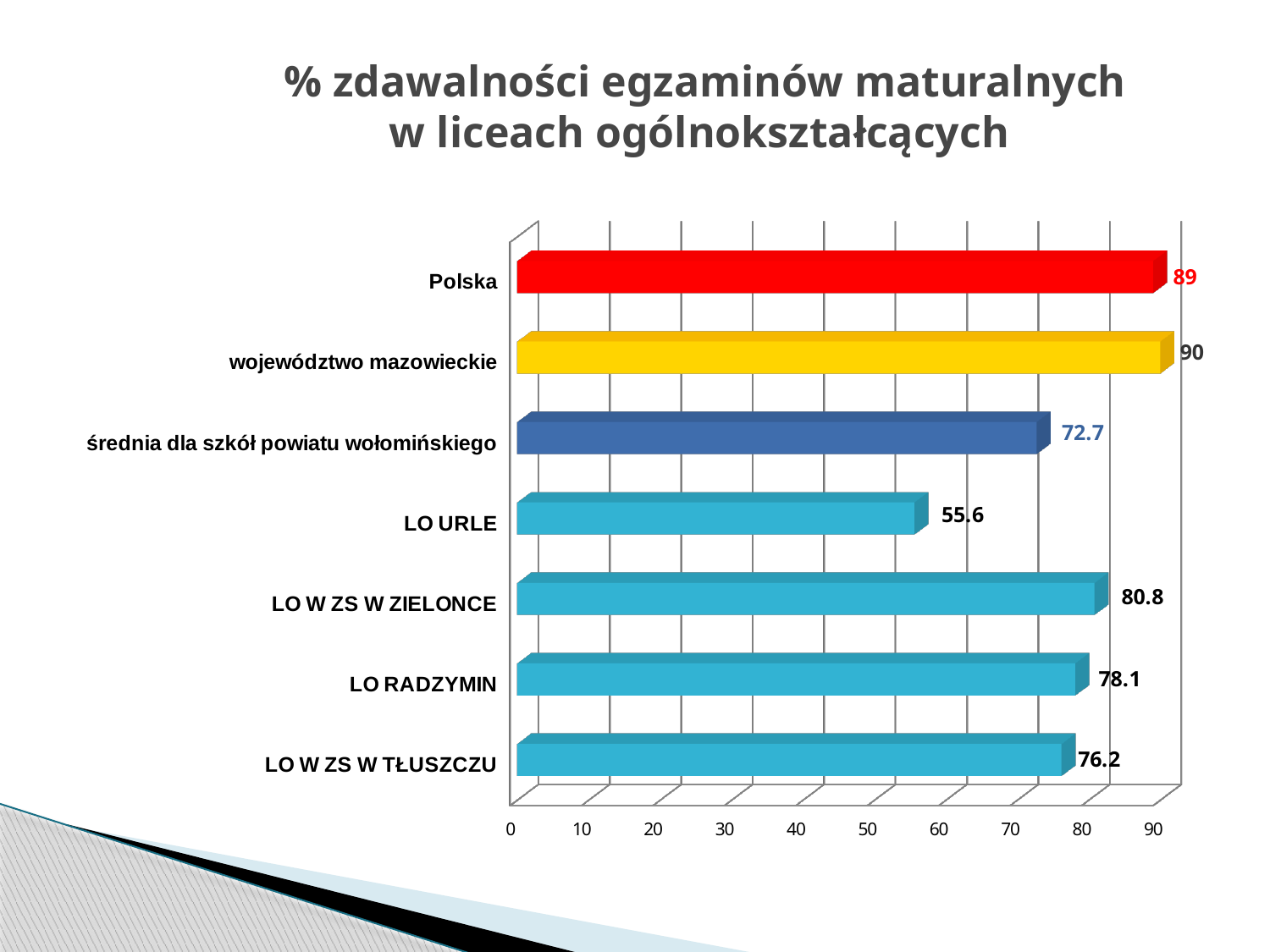
What is the value for średnia dla szkół powiatu wołomińskiego? 72.7 What is the value for Polska? 89 How many categories are shown in the chart? 7 What is the value for LO W ZS W TŁUSZCZU? 76.2 What is the value for LO URLE? 55.6 Which category has the highest value? województwo mazowieckie What colour is the bar for Polska? red What kind of chart is shown on the slide? bar chart Which category has the lowest value? LO URLE Is the value for LO URLE greater or less than 60? less Which is larger, the value for LO RADZYMIN or the value for LO W ZS W TŁUSZCZU? LO RADZYMIN What is the difference between the values for LO W ZS W ZIELONCE and LO RADZYMIN? 2.7